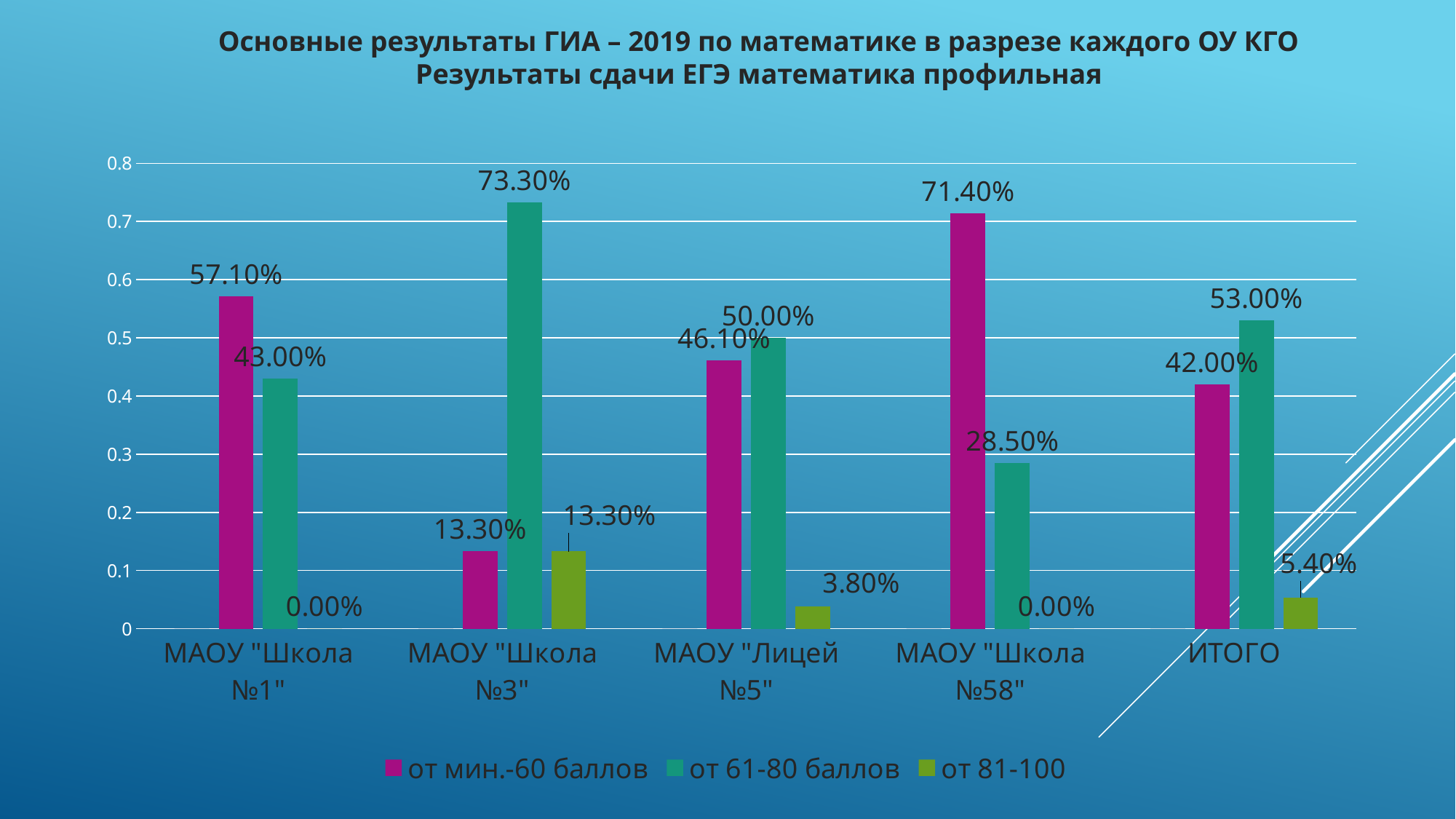
For МАОУ "Лицей №5", which is larger: the "от мин.-60 баллов" value or the "от 61-80 баллов" value? от 61-80 баллов What is the value for МАОУ "Школа №1" in the series "от мин.-60 баллов"? 57.10% How many categories are shown on the x axis? 5 What is the difference between the "от 61-80 баллов" value and the "от мин.-60 баллов" value for МАОУ "Школа №3"? 60.00% Which category has the lowest value in the series "от 61-80 баллов"? МАОУ "Школа №58" What is the value for МАОУ "Школа №3" in the series "от 61-80 баллов"? 73.30% What is the value for ИТОГО in the series "от 81-100"? 5.40% Which category has the highest value in the series "от мин.-60 баллов"? МАОУ "Школа №58" Which colour represents the series "от 81-100" in the legend? Green How many series does the legend list? 3 What is the value for МАОУ "Лицей №5" in the series "от 81-100"? 3.80% What kind of chart is shown on the slide? Bar chart